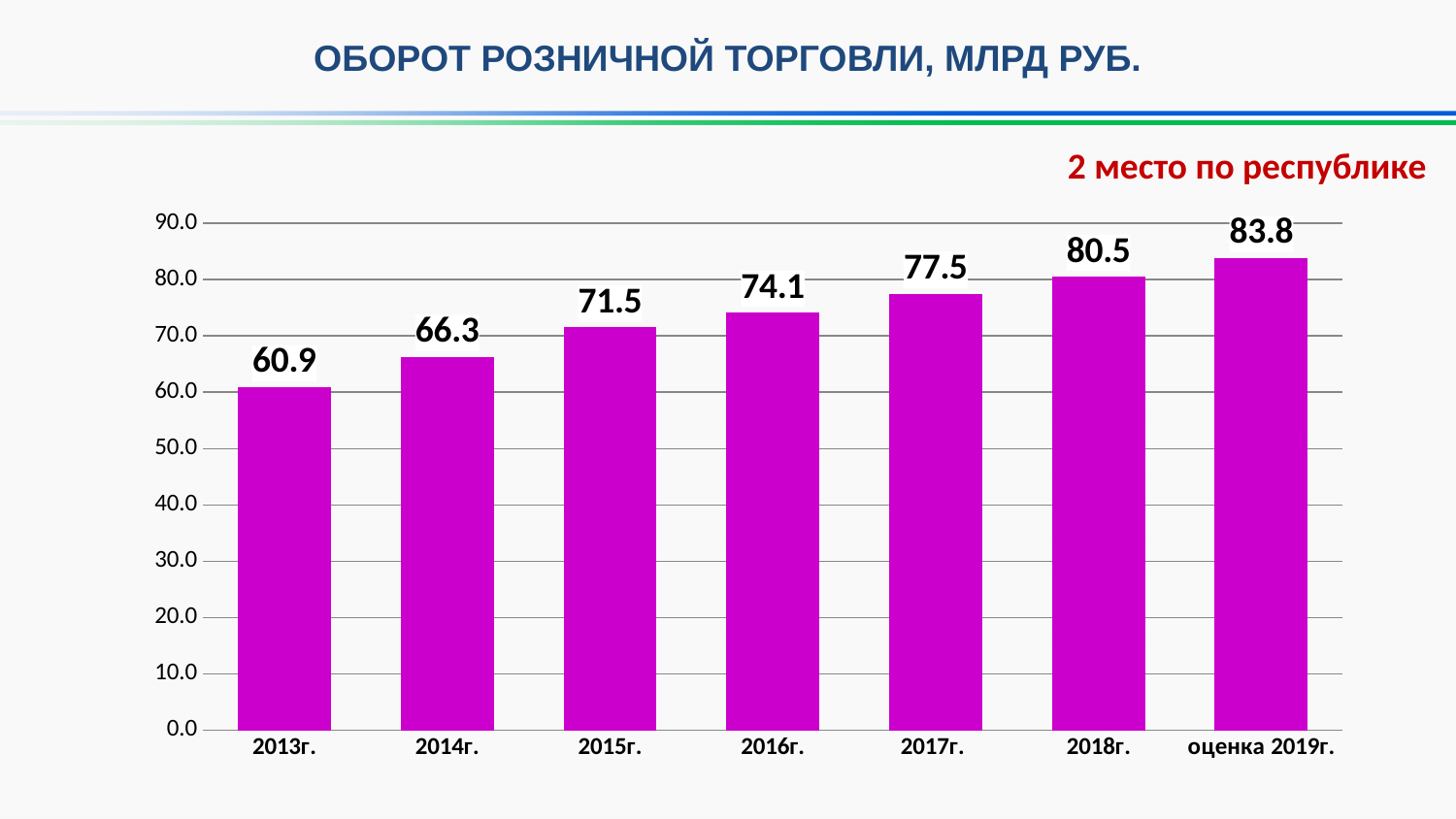
What is the value for 2016г.? 74.1 What is the difference between the values for оценка 2019г. and 2013г.? 22.9 What kind of chart is shown on the slide? bar chart How many categories are shown on the x axis? 7 Do the values rise or fall from 2013г. to оценка 2019г.? rise What is the value for оценка 2019г.? 83.8 Which category has the highest value? оценка 2019г. Which category has the lowest value? 2013г. What is the difference between the values for 2018г. and 2017г.? 3.0 Which is larger, the value for 2015г. or the value for 2014г.? 2015г. What is the value for 2013г.? 60.9 Is the value for 2017г. greater or less than 70.0? greater